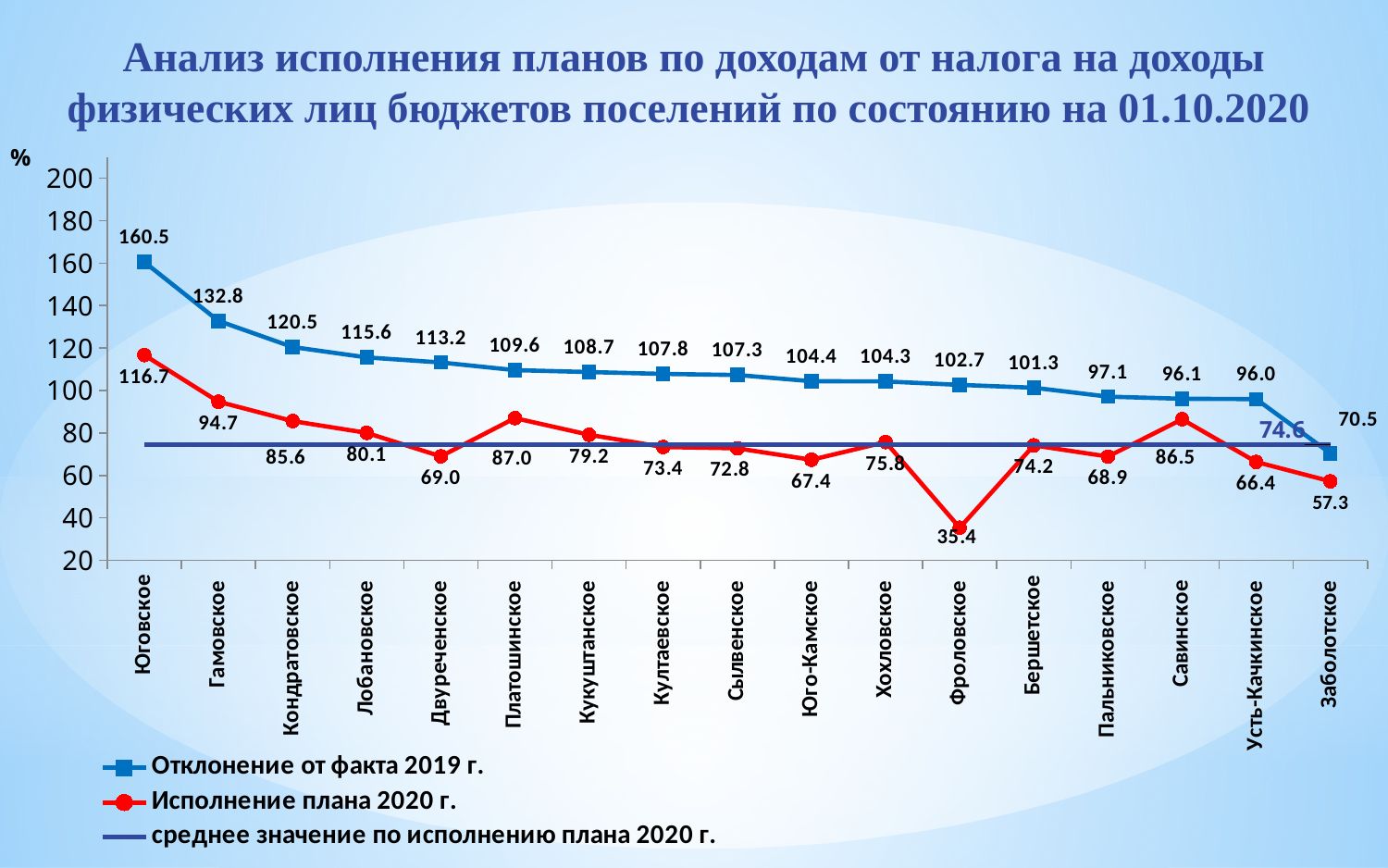
How many settlements (categories) are plotted along the x axis? 17 What is the value of the 'среднее значение по исполнению плана 2020 г.' line? 74.6 What type of chart is shown on the slide? line chart What is the difference between the 'Отклонение от факта 2019 г.' and 'Исполнение плана 2020 г.' values for Гамовское? 38.1 Does the 'Отклонение от факта 2019 г.' series rise or fall from left to right along the x axis? fall Which is larger for Платошинское: 'Отклонение от факта 2019 г.' or 'Исполнение плана 2020 г.'? Отклонение от факта 2019 г. Which settlement has the highest value for 'Отклонение от факта 2019 г.'? Юговское What is the value of 'Исполнение плана 2020 г.' for Савинское? 86.5 What is the value of 'Отклонение от факта 2019 г.' for Юговское? 160.5 Which settlement has the lowest value for 'Исполнение плана 2020 г.'? Фроловское How many series does the legend list? 3 What is the value of 'Исполнение плана 2020 г.' for Фроловское? 35.4